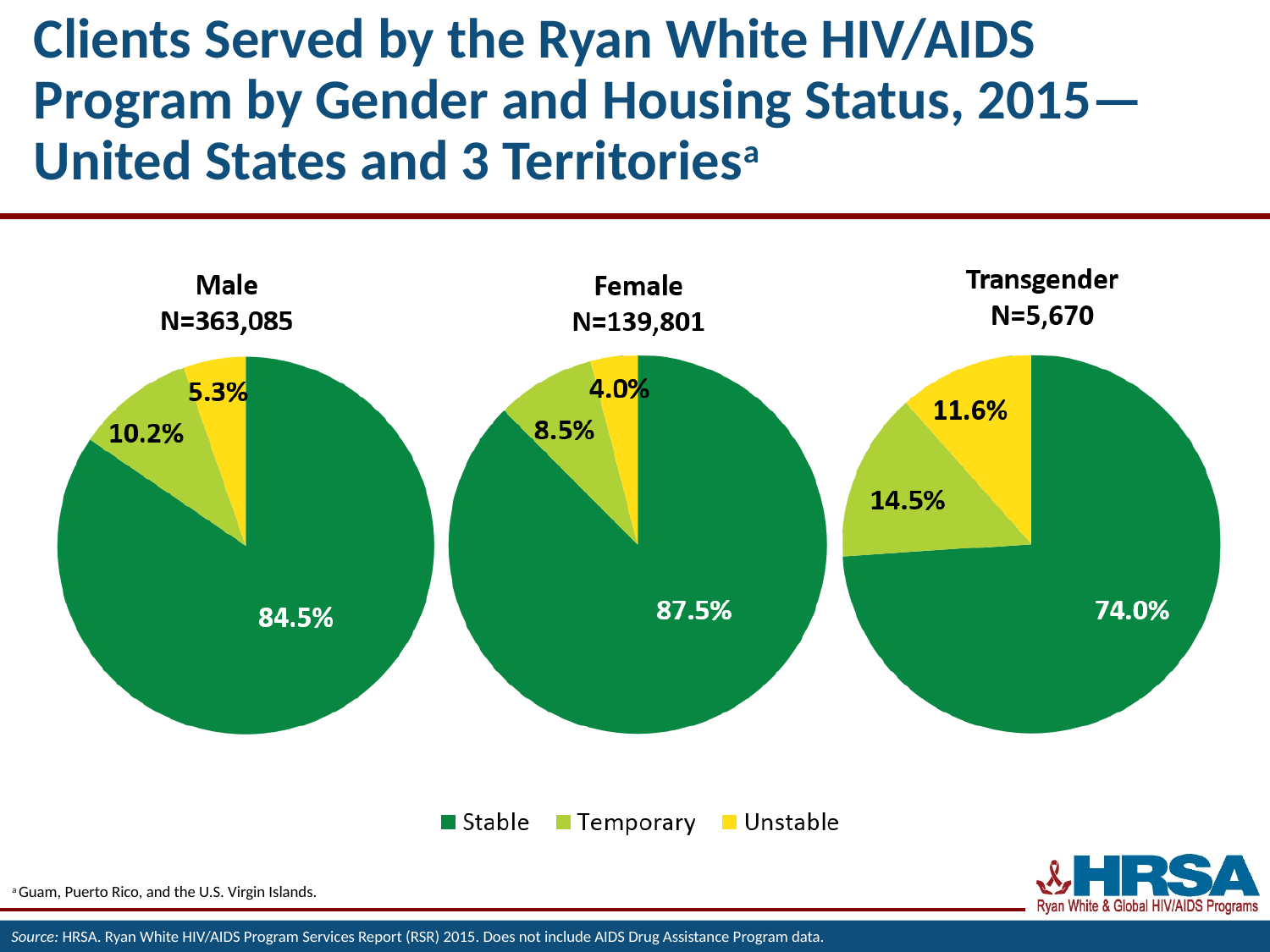
How many housing status categories does the legend list? 3 In the Female pie chart, what percentage of clients had unstable housing? 4.0% In the Transgender pie chart, which housing status has the largest share? Stable Which is larger: the unstable housing share in the Male pie chart or in the Transgender pie chart? Transgender How many pie charts are shown on the slide? 3 In the Male pie chart, what percentage of clients had stable housing? 84.5% What is the difference between the stable housing share in the Female pie chart and the stable housing share in the Transgender pie chart? 13.5% What is the N value shown for the Female pie chart? N=139,801 Which colour represents the Unstable housing category in the legend? Yellow In the Male pie chart, which housing status has the smallest share? Unstable What type of chart is used to show housing status by gender on this slide? Pie chart In the Transgender pie chart, what percentage of clients had temporary housing? 14.5%